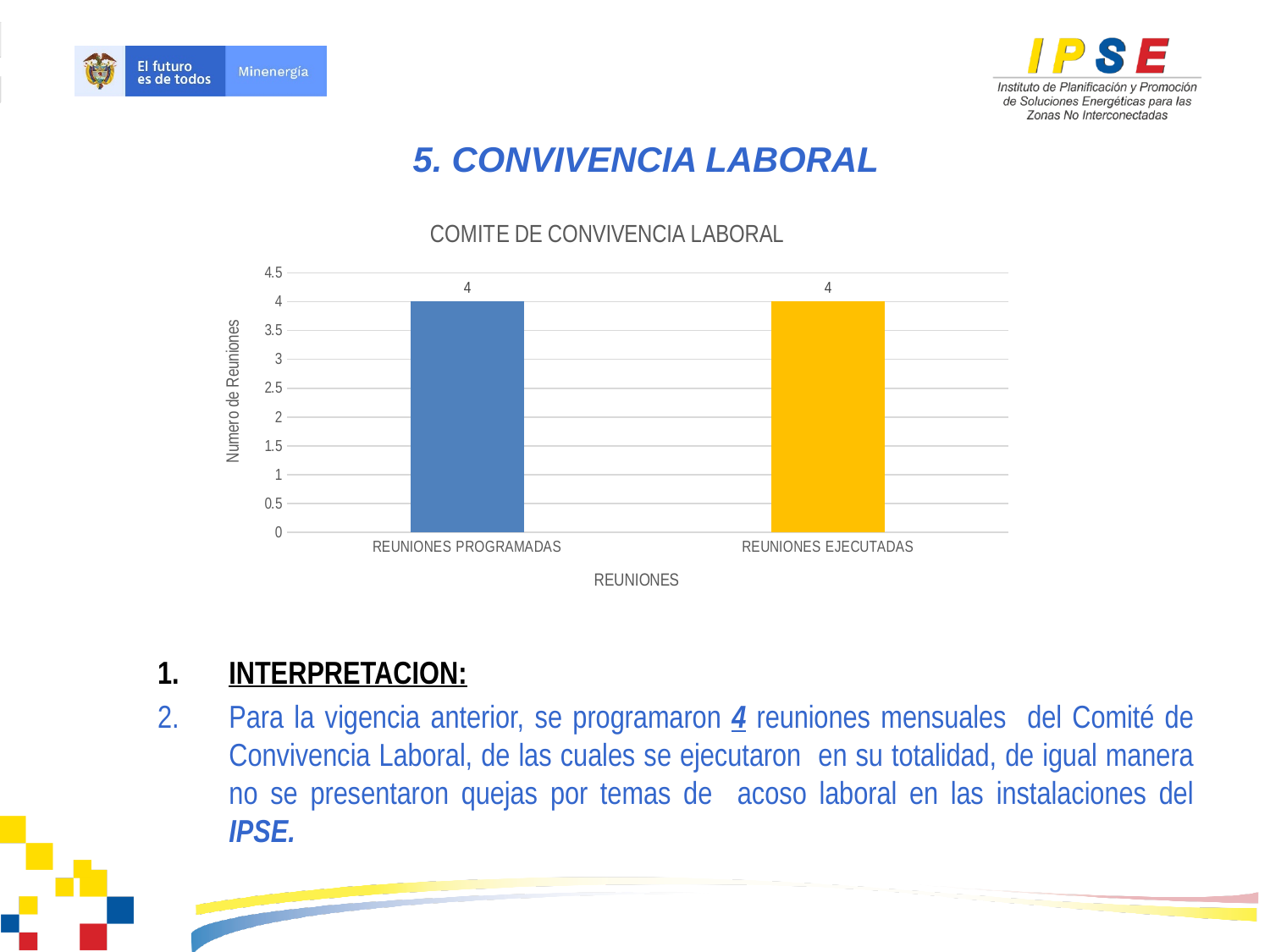
What is the value for REUNIONES PROGRAMADAS? 4 What kind of chart is shown? Bar chart Is the value for REUNIONES PROGRAMADAS greater or less than 4.5? less How many categories are shown on the x axis? 2 What is the value for REUNIONES EJECUTADAS? 4 What is the total of REUNIONES PROGRAMADAS and REUNIONES EJECUTADAS? 8 What is the difference between REUNIONES PROGRAMADAS and REUNIONES EJECUTADAS? 0 Is the value for REUNIONES EJECUTADAS greater or less than 3? greater What is the label of the y axis? Numero de Reuniones What is the title of the chart? COMITE DE CONVIVENCIA LABORAL